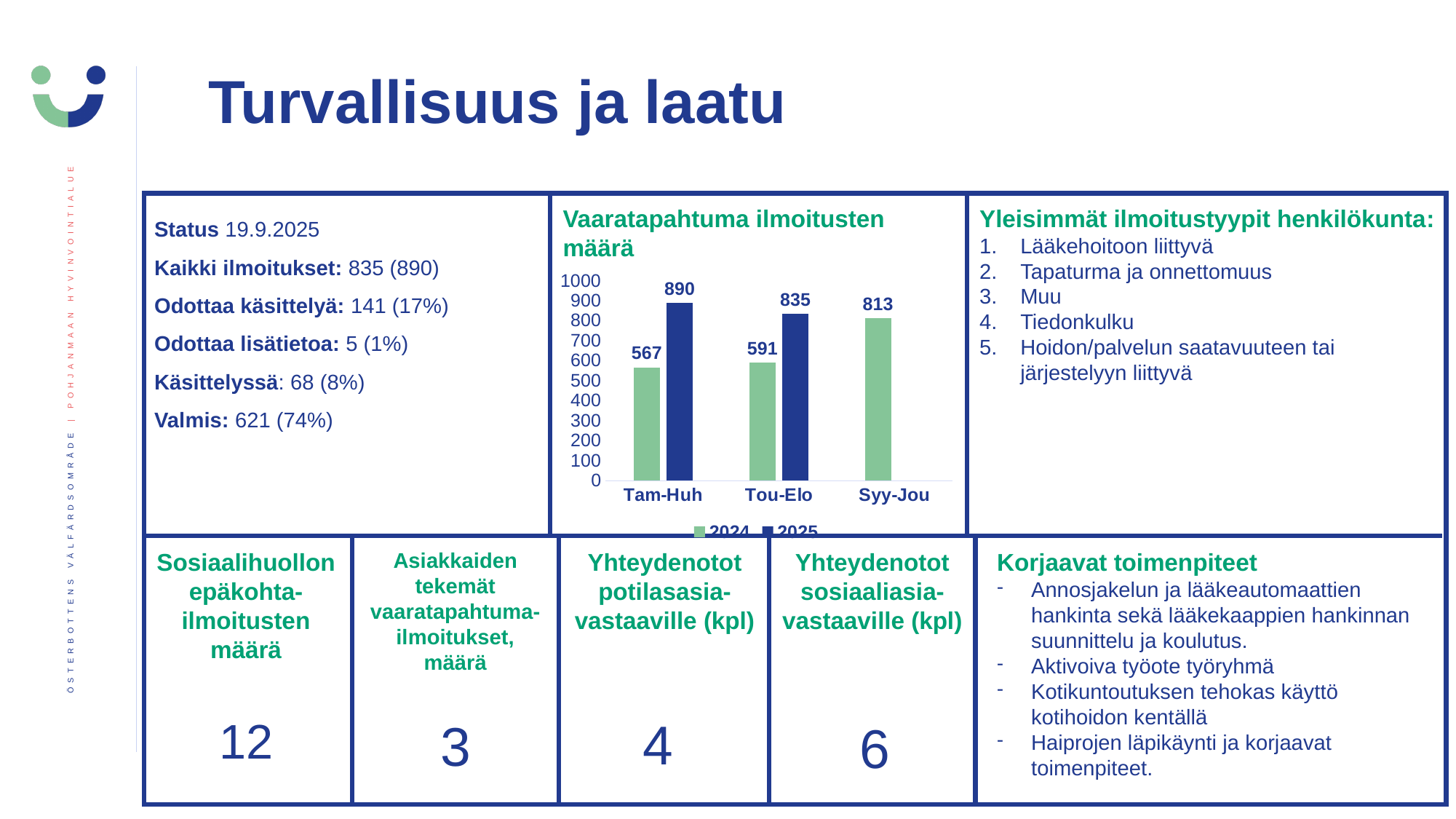
Do the 2024 values rise or fall from Tam-Huh to Syy-Jou in the Vaaratapahtuma ilmoitusten määrä chart? Rise How many series does the legend of the Vaaratapahtuma ilmoitusten määrä chart list? 2 What is the difference between the 2025 and 2024 values for Tou-Elo in the Vaaratapahtuma ilmoitusten määrä chart? 244 What is the value for 2024 in Tam-Huh in the Vaaratapahtuma ilmoitusten määrä chart? 567 How many categories are shown on the x axis of the Vaaratapahtuma ilmoitusten määrä chart? 3 In the Vaaratapahtuma ilmoitusten määrä chart, which is larger: the 2024 value for Tou-Elo or the 2024 value for Syy-Jou? Syy-Jou Which category has the highest 2025 value in the Vaaratapahtuma ilmoitusten määrä chart? Tam-Huh Which category has the lowest 2024 value in the Vaaratapahtuma ilmoitusten määrä chart? Tam-Huh What is the difference between the 2025 and 2024 values for Tam-Huh in the Vaaratapahtuma ilmoitusten määrä chart? 323 What is the value for 2025 in Tou-Elo in the Vaaratapahtuma ilmoitusten määrä chart? 835 What is the value for 2024 in Syy-Jou in the Vaaratapahtuma ilmoitusten määrä chart? 813 What kind of chart is the Vaaratapahtuma ilmoitusten määrä chart? Bar chart